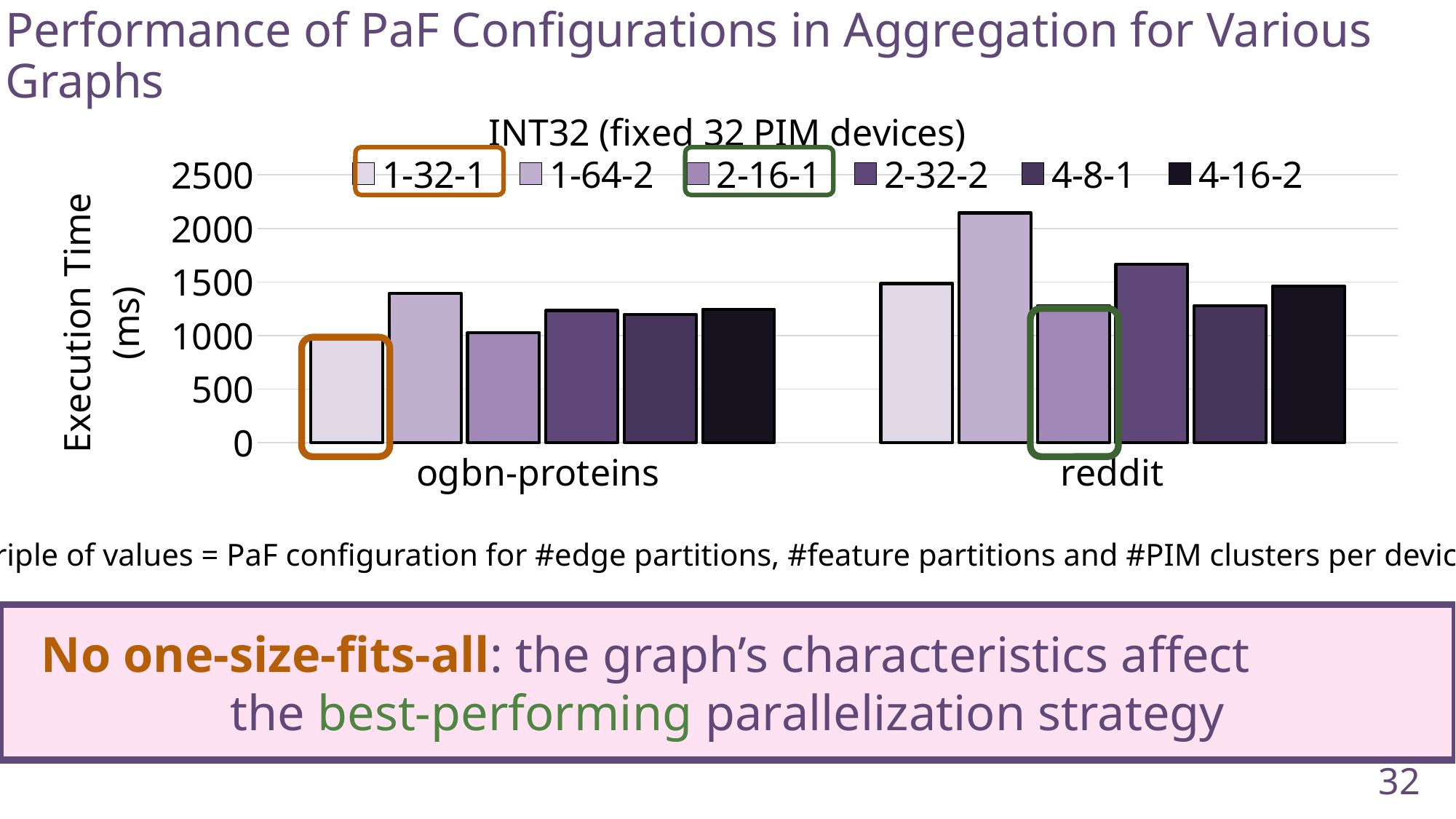
What is the title of the chart? INT32 (fixed 32 PIM devices) Is the execution time for 1-64-2 on reddit greater or less than 2000? greater How many series does the legend list? 6 Which PaF configuration has the highest execution time for ogbn-proteins? 1-64-2 Which PaF configuration has the highest execution time for reddit? 1-64-2 What kind of chart is shown on the slide? bar chart How many graph categories are shown on the x axis? 2 Which has the larger execution time for configuration 1-64-2: ogbn-proteins or reddit? reddit Which PaF configuration has the lowest execution time for ogbn-proteins? 1-32-1 Which PaF configuration has the lowest execution time for reddit? 2-16-1 What is the label of the y axis? Execution Time (ms)